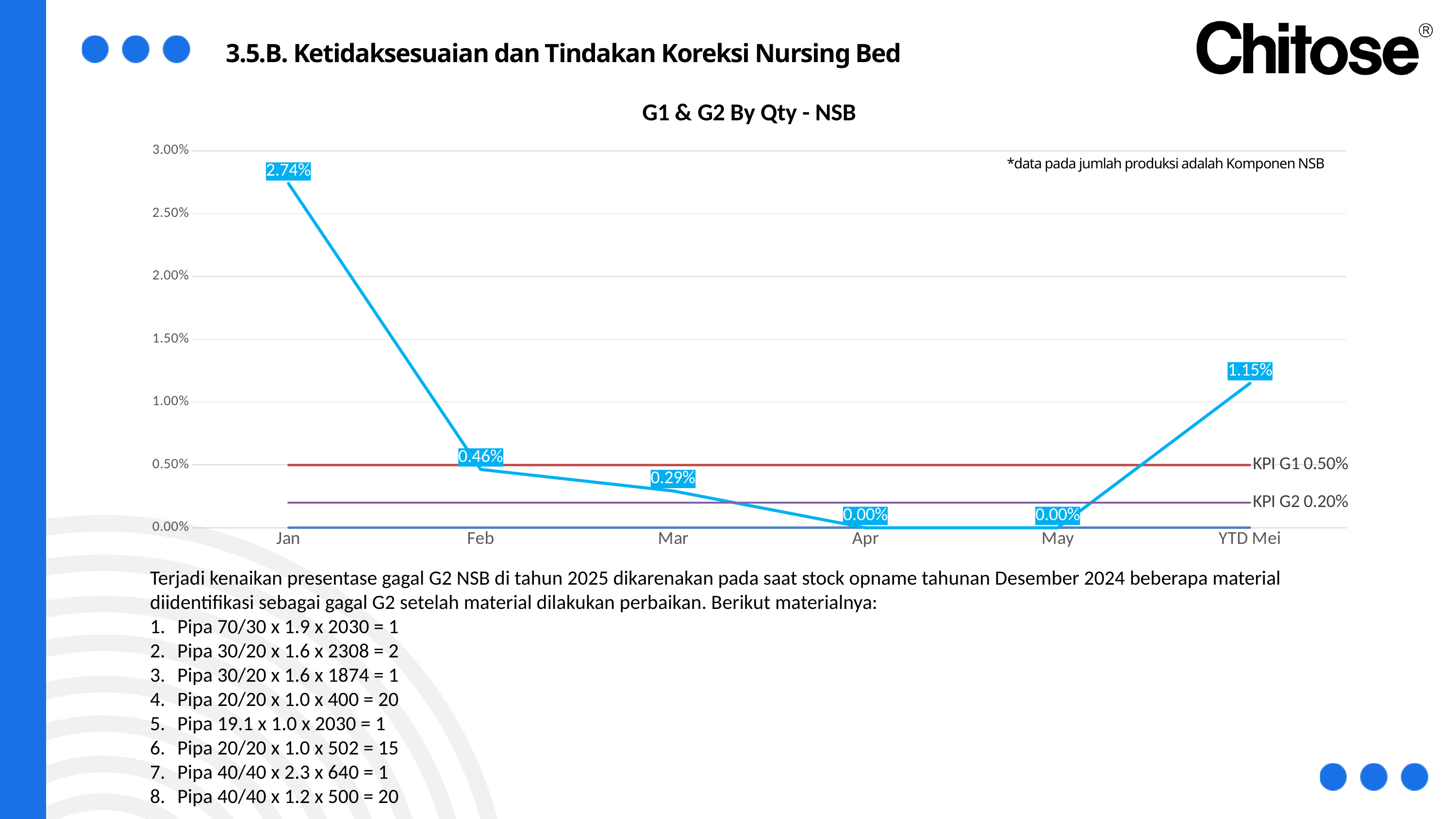
What is the value for Jan? 2.74% What is the value for YTD Mei? 1.15% What is the value for Feb? 0.46% Which is larger, the value for Feb or the value for Mar? Feb Do the values rise or fall from Jan to Apr? fall What is the title of the chart? G1 & G2 By Qty - NSB How many categories are shown on the x axis? 6 What type of chart is shown on the slide? line chart What is the difference between the values for Jan and Feb? 2.28% Which month has the highest value? Jan What value is shown for the KPI G1 reference line? 0.50% What is the value for Mar? 0.29%